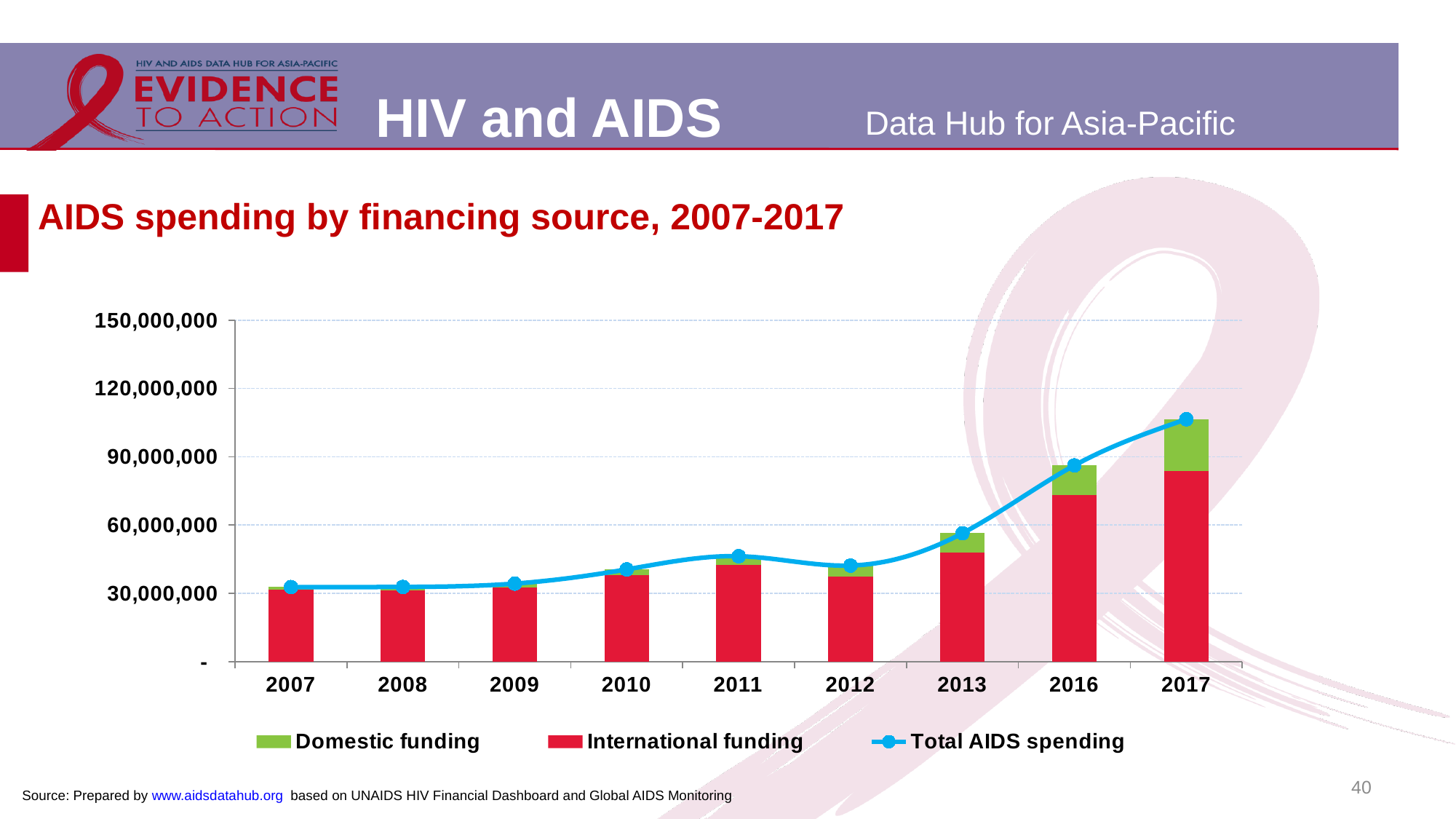
How many years are shown on the x axis of the chart? 9 Is the total AIDS spending for 2016 greater or less than 60,000,000? greater Which colour represents Domestic funding in the chart? Green What is the title of the chart? AIDS spending by financing source, 2007-2017 Which year has larger total AIDS spending, 2013 or 2016? 2016 Is the international funding for 2017 greater or less than 60,000,000? greater Does total AIDS spending generally rise or fall from 2007 to 2017? Rise What kind of chart is shown on the slide? A stacked bar chart with a line Is the total AIDS spending for 2011 greater or less than 60,000,000? less Which year has the highest total AIDS spending? 2017 How many series does the chart legend list? 3